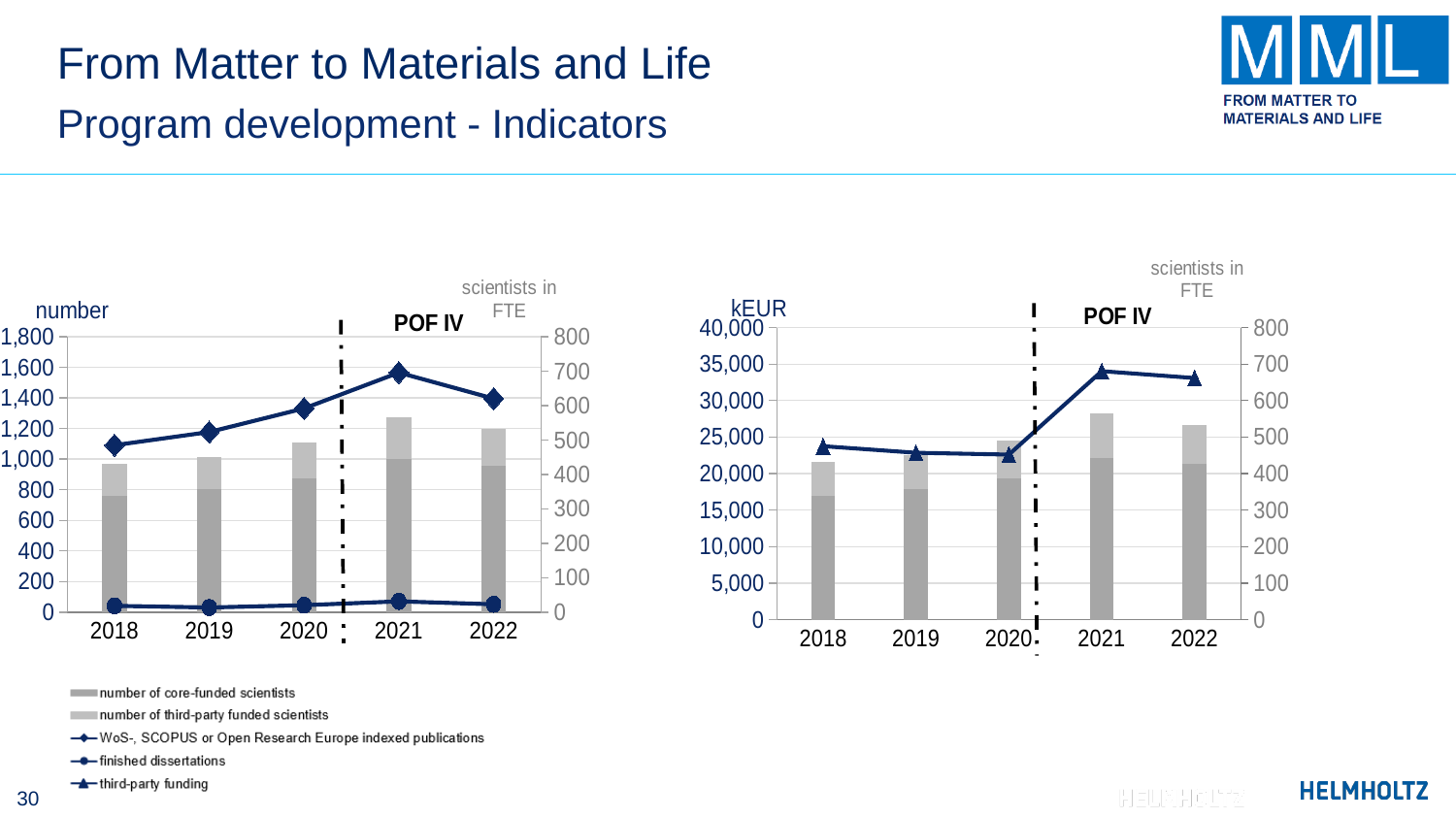
On the right chart, which year has higher third-party funding, 2019 or 2021? 2021 How many years are shown on the x axis of the right chart? 5 How many entries does the legend at the bottom left of the slide list? 5 On the right chart, is third-party funding in 2018 greater or less than 30,000 kEUR? less What label is printed above the dashed vertical line on each chart? POF IV On the left chart, in which year is the number of WoS-, SCOPUS or Open Research Europe indexed publications highest? 2021 On the left chart, in which year is the number of indexed publications lowest? 2018 On the left chart, do the indexed publications rise or fall from 2018 to 2021? rise On the right chart, is third-party funding in 2021 greater or less than 30,000 kEUR? greater On the left chart, is the number of indexed publications in 2021 greater or less than 1,400? greater